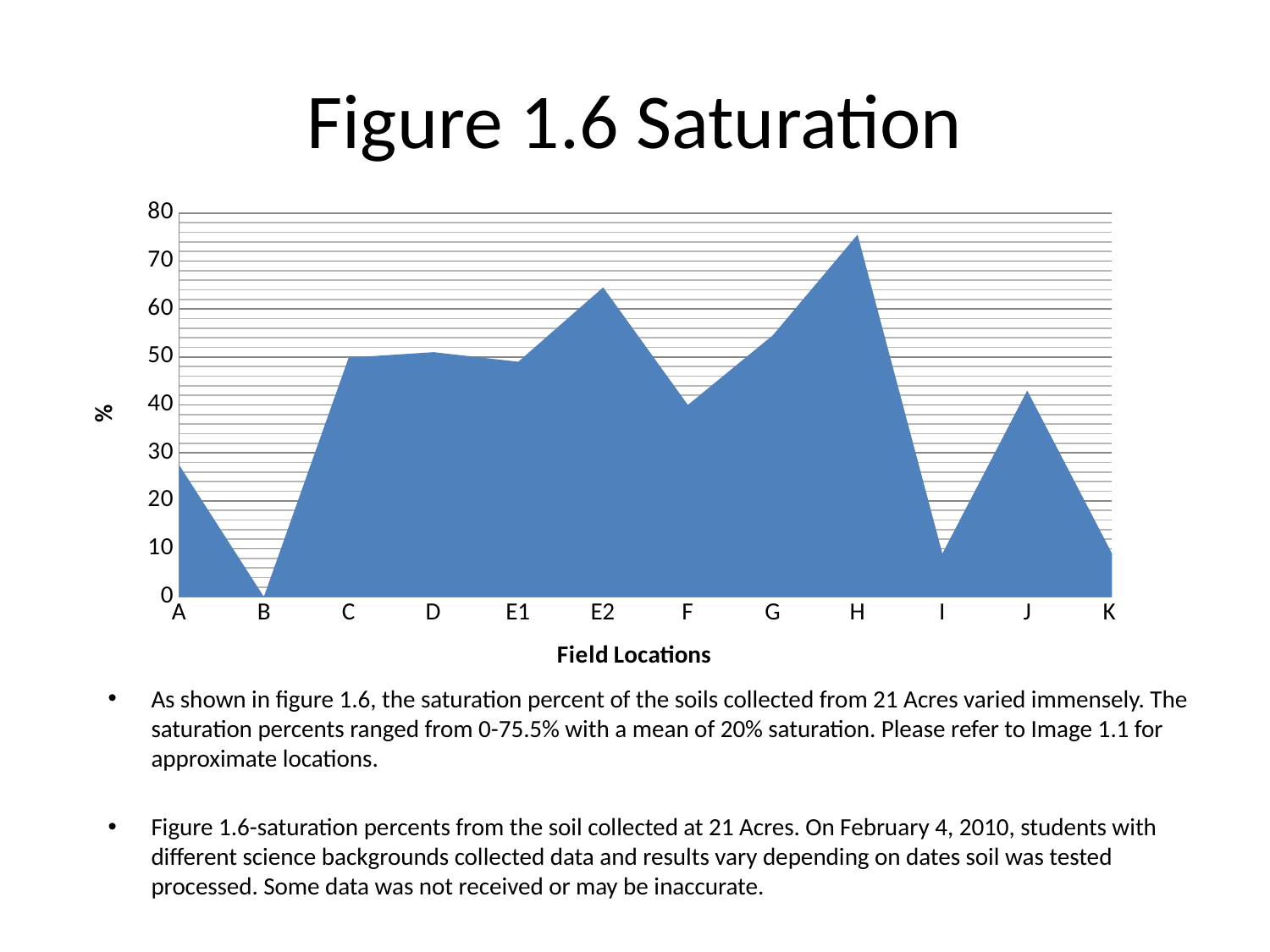
Which has the larger saturation value, field location H or field location E2? H What kind of chart is shown on the slide? area chart Is the value for field location A greater or less than 30? less Which field location has the lowest saturation value? B Is the value for field location H greater or less than 70? greater Which field location has the highest saturation value? H Is the value for field location I greater or less than 20? less What is the title of the x axis? Field Locations How many field locations are plotted along the x axis? 12 Which has the larger saturation value, field location A or field location J? J What is the saturation value for field location B? 0